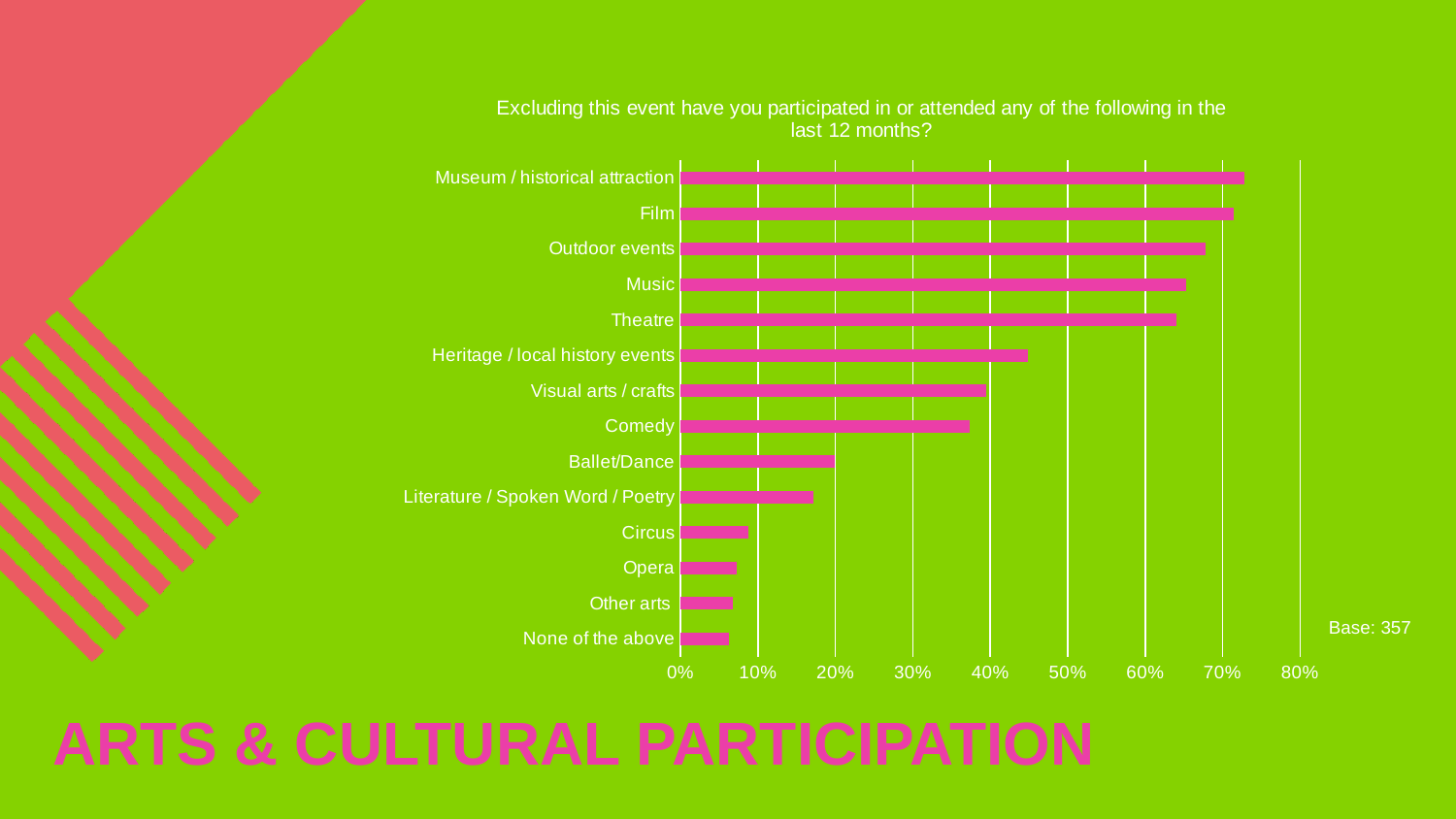
Is the value for Ballet/Dance greater or less than 30%? less Is the value for Comedy greater or less than 40%? less What is the base (number of respondents) shown next to the chart? Base: 357 What kind of chart is shown on the slide? bar chart Do the bar values increase or decrease going from the top category to the bottom category? decrease Is the value for Museum / historical attraction greater or less than 70%? greater Which has the larger value, Outdoor events or Theatre? Outdoor events How many categories are plotted in the chart? 14 Which has the larger value, Heritage / local history events or Comedy? Heritage / local history events